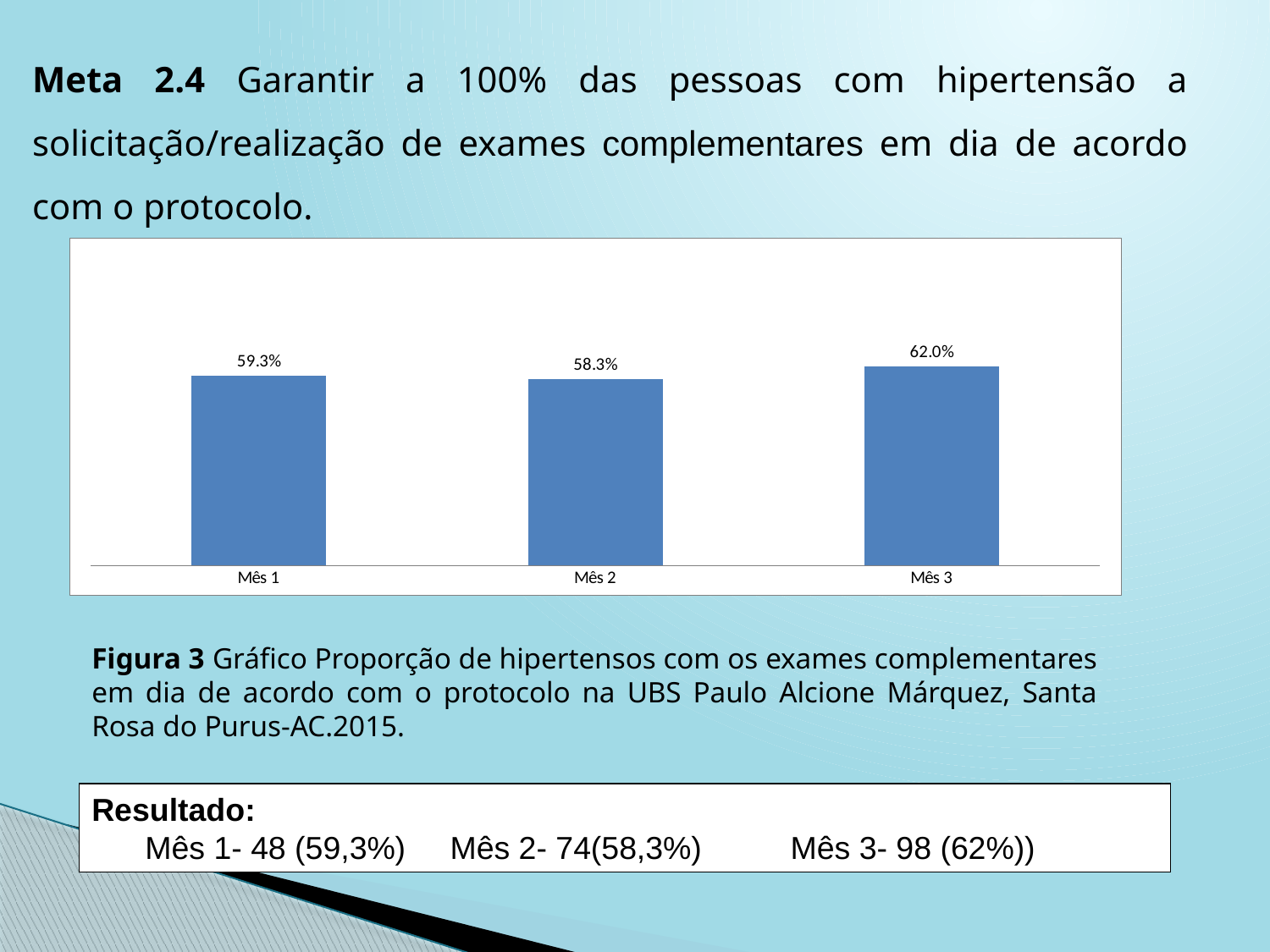
What is the value for Mês 3? 62.0% Does the value rise or fall from Mês 2 to Mês 3? Rise What colour are the bars in the chart? Blue Which month has the lowest value? Mês 2 How many categories are shown on the x axis of the chart? 3 What kind of chart is shown on the slide? Bar chart What is the difference between the values for Mês 3 and Mês 1? 2.7% What is the difference between the values for Mês 1 and Mês 2? 1.0% What is the value for Mês 2? 58.3% Which month has the highest value? Mês 3 Which is larger, the value for Mês 3 or the value for Mês 2? Mês 3 What is the value for Mês 1? 59.3%